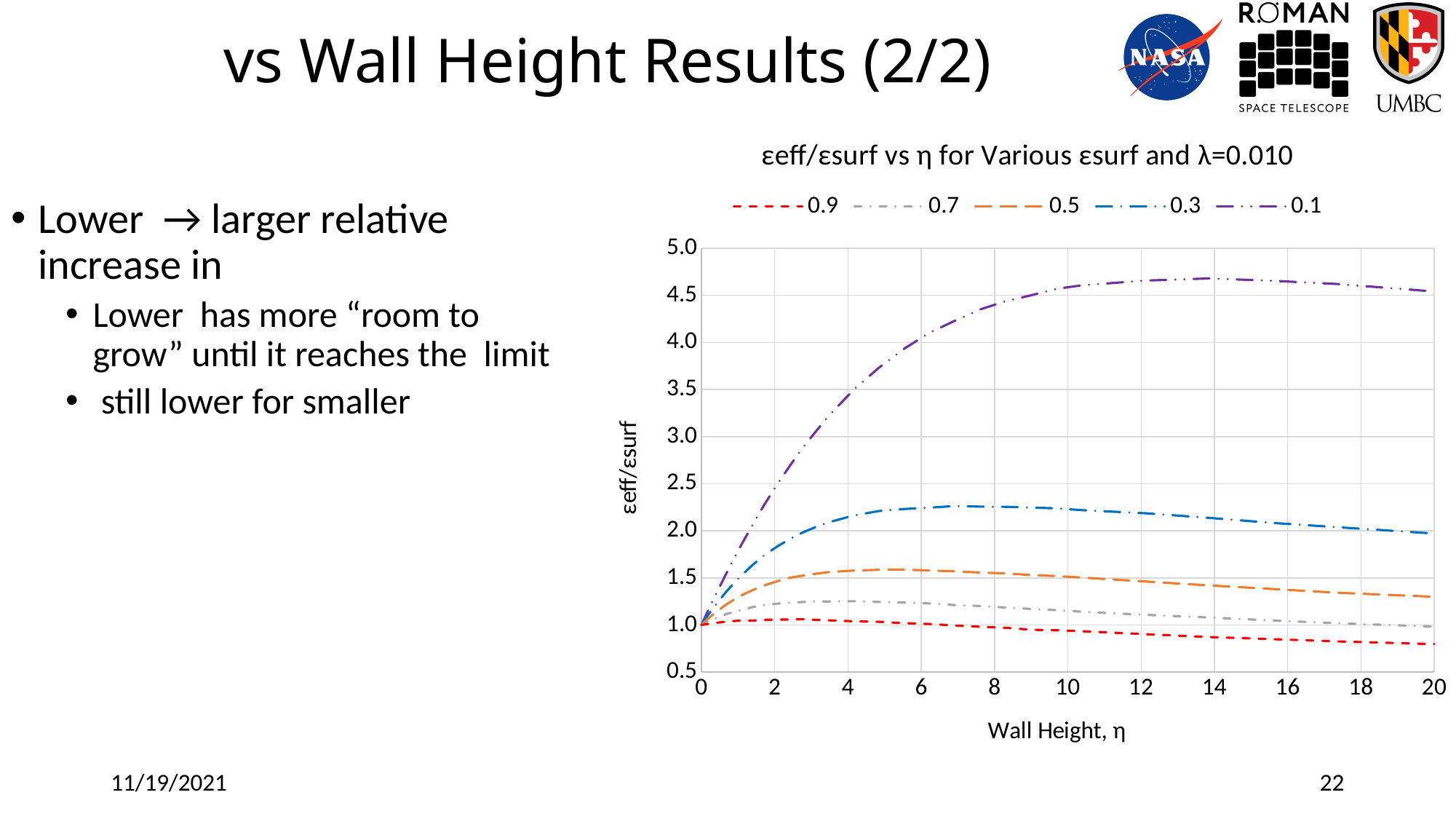
Is the value of the 0.1 series at wall height η=8 greater or less than 4.0? greater What kind of chart is shown on the slide? line chart At wall height η=10, which series has the larger value, 0.1 or 0.3? 0.1 Is the value of the 0.9 series at wall height η=20 greater or less than 1.0? less What is the label of the x axis? Wall Height, η Which series has the lowest value at wall height η=20? 0.9 Which series has the highest value at wall height η=20? 0.1 Does the 0.9 series rise or fall as wall height increases from η=4 to η=20? fall What is the title of the chart? εeff/εsurf vs η for Various εsurf and λ=0.010 Is the value of the 0.5 series at wall height η=20 greater or less than 1.0? greater How many series does the legend list? 5